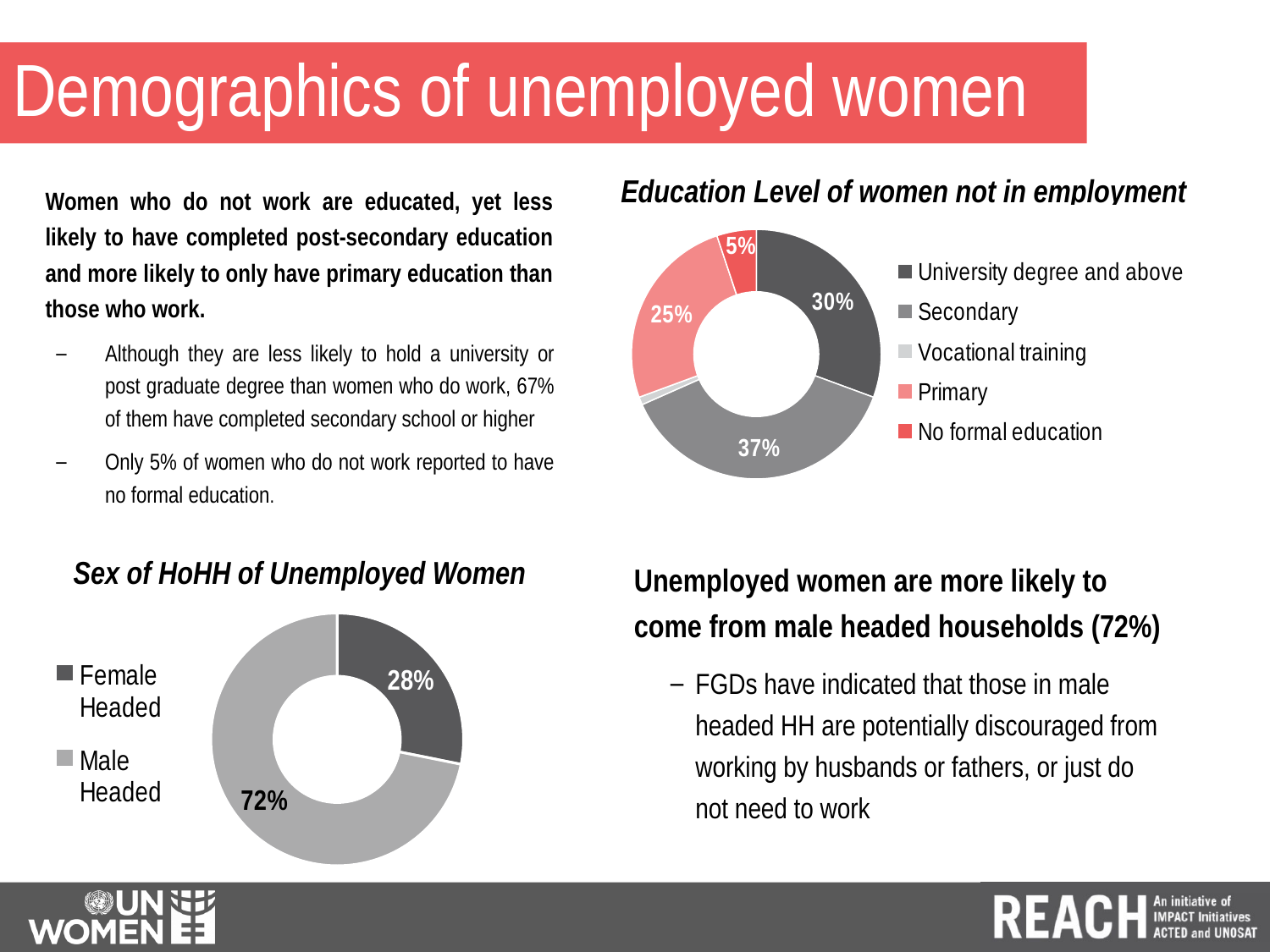
In the 'Education Level of women not in employment' chart, what share of women have secondary education? 37% In the 'Education Level of women not in employment' chart, which education level has the largest share? Secondary In the 'Education Level of women not in employment' chart, which is larger: the share with a university degree and above or the share with primary education? University degree and above In the 'Education Level of women not in employment' chart, what colour is the Primary slice? Light red (pink) What kind of chart is the 'Sex of HoHH of Unemployed Women' chart? Doughnut chart In the 'Education Level of women not in employment' chart, what share of women have no formal education? 5% In the 'Sex of HoHH of Unemployed Women' chart, what share of unemployed women are from female headed households? 28% In the 'Sex of HoHH of Unemployed Women' chart, what share of unemployed women are from male headed households? 72% How many categories does the legend of the 'Education Level of women not in employment' chart list? 5 In the 'Education Level of women not in employment' chart, what share of women have a university degree and above? 30% In the 'Education Level of women not in employment' chart, what is the difference between the Secondary and Primary shares? 12% In the 'Sex of HoHH of Unemployed Women' chart, what is the difference between the Male Headed and Female Headed shares? 44%